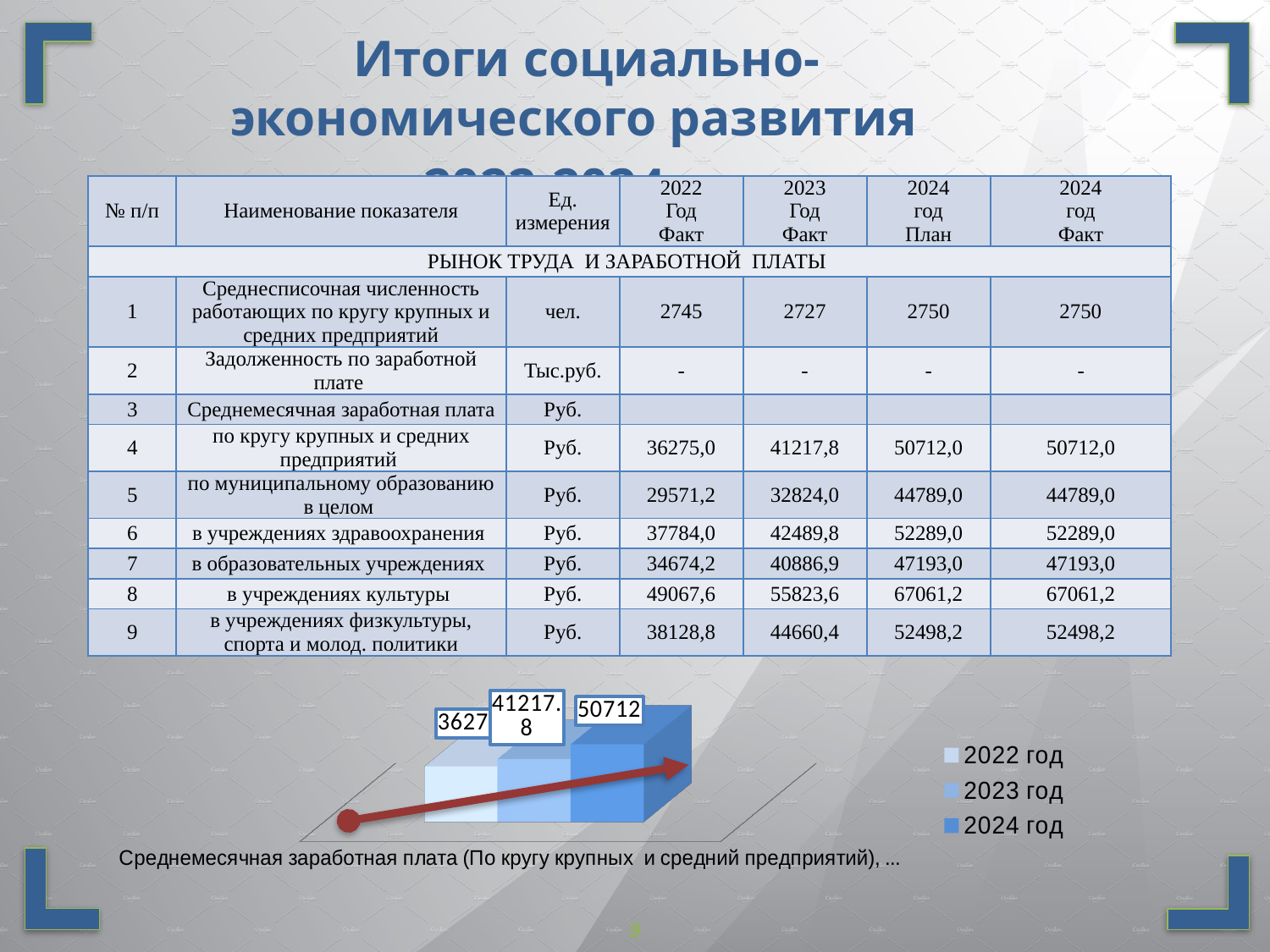
How many bars are plotted in the chart? 3 In the chart, which is larger: the value for 2023 год or for 2024 год? 2024 год What is the difference between the chart values for 2024 год and 2023 год? 9494.2 Which year has the lowest value in the chart? 2022 год What value does the chart show for 2023 год? 41217.8 What entries are listed in the chart legend? 2022 год, 2023 год, 2024 год How many series does the legend of the chart list? 3 What indicator does the chart's category label say it shows? Среднемесячная заработная плата (По кругу крупных и средний предприятий), ... What value does the chart show for 2024 год? 50712 Which year has the highest value in the chart? 2024 год Do the values in the chart rise or fall from 2022 to 2024? rise What kind of chart is shown at the bottom of the slide? bar chart